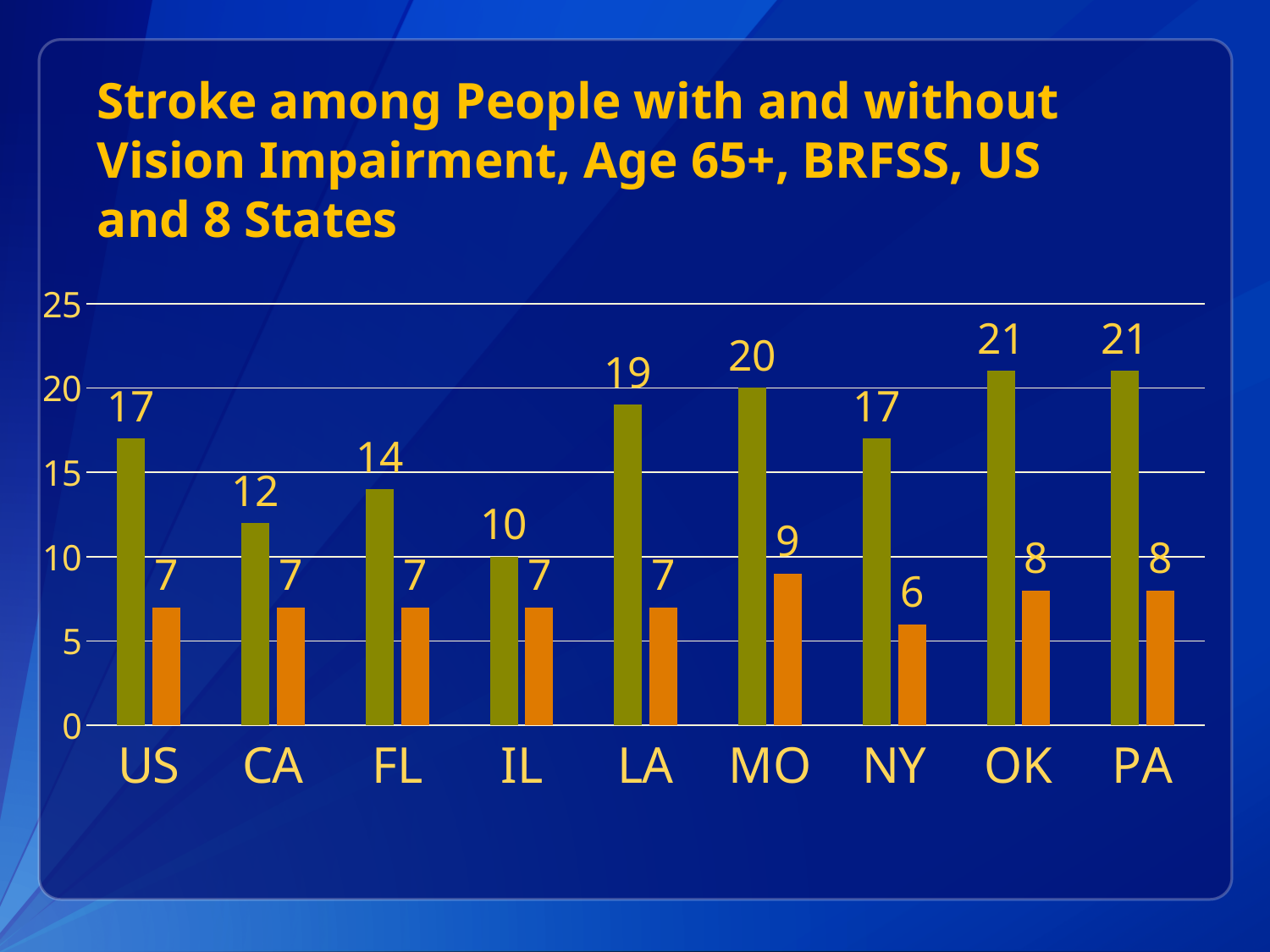
How many categories are shown on the x axis? 9 What is the title of the chart? Stroke among People with and without Vision Impairment, Age 65+, BRFSS, US and 8 States Which category has the lowest green bar? IL What is the difference between the green bar and the orange bar for LA? 12 What kind of chart is shown on the slide? bar chart What is the value of the green bar for MO? 20 Which category has the lowest orange bar? NY Which is larger, the green bar for FL or the green bar for NY? NY What is the value of the green bar for IL? 10 What is the value of the orange bar for NY? 6 What is the difference between the green bars for OK and CA? 9 What is the value of the orange bar for MO? 9